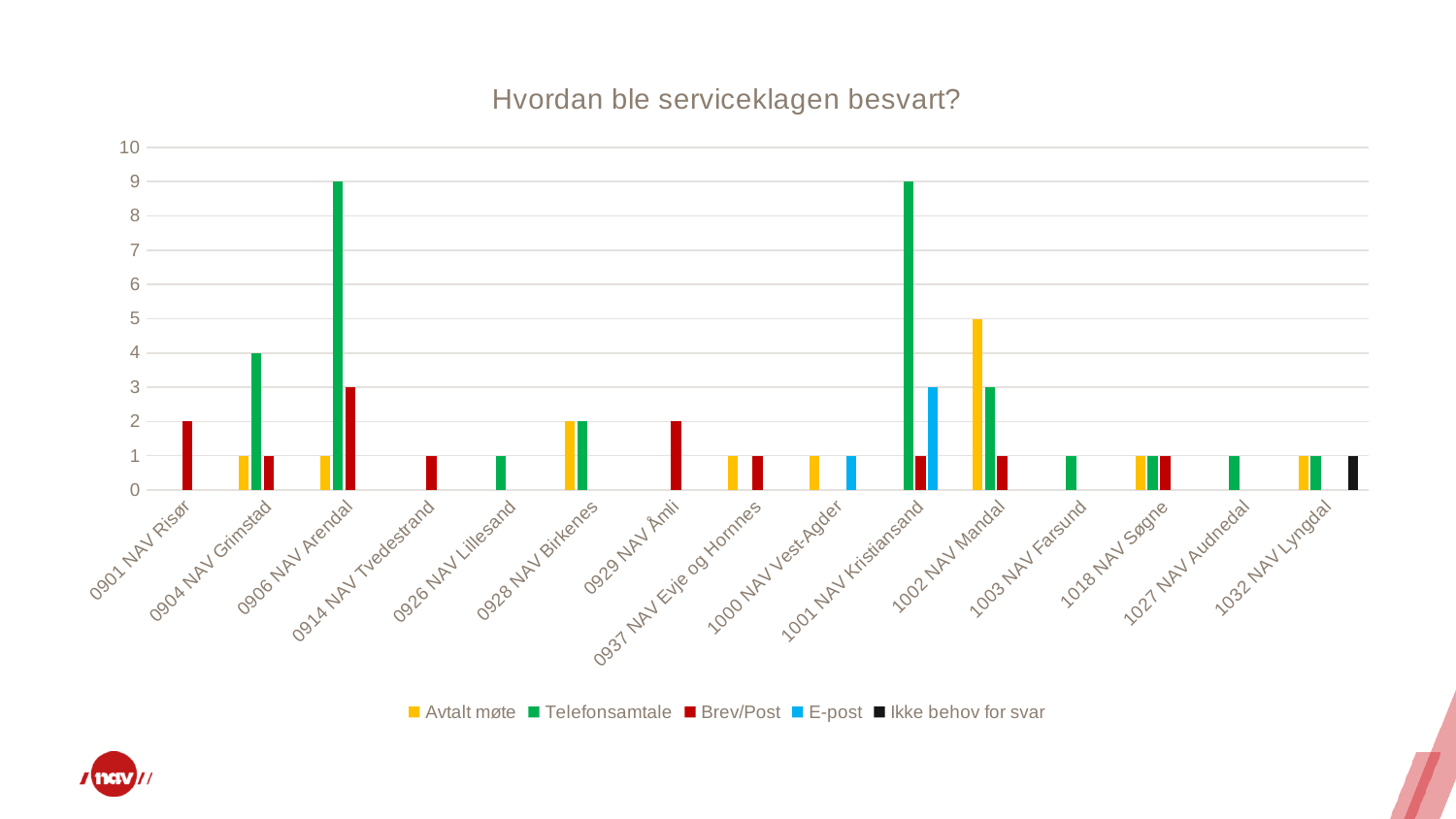
Which office has the highest Avtalt møte value? 1002 NAV Mandal Which office has the highest Brev/Post value? 0906 NAV Arendal How many series does the legend list? 5 What is the title of the chart? Hvordan ble serviceklagen besvart? What is the Telefonsamtale value for 0906 NAV Arendal? 9 What type of chart is shown on the slide? Bar chart What is the E-post value for 1001 NAV Kristiansand? 3 Which is larger for 0904 NAV Grimstad: Telefonsamtale or Brev/Post? Telefonsamtale What is the difference between the Telefonsamtale value and the Brev/Post value for 0906 NAV Arendal? 6 Which office is the only one with a value for Ikke behov for svar? 1032 NAV Lyngdal What is the Avtalt møte value for 1002 NAV Mandal? 5 How many NAV offices (categories) are shown on the x axis? 15